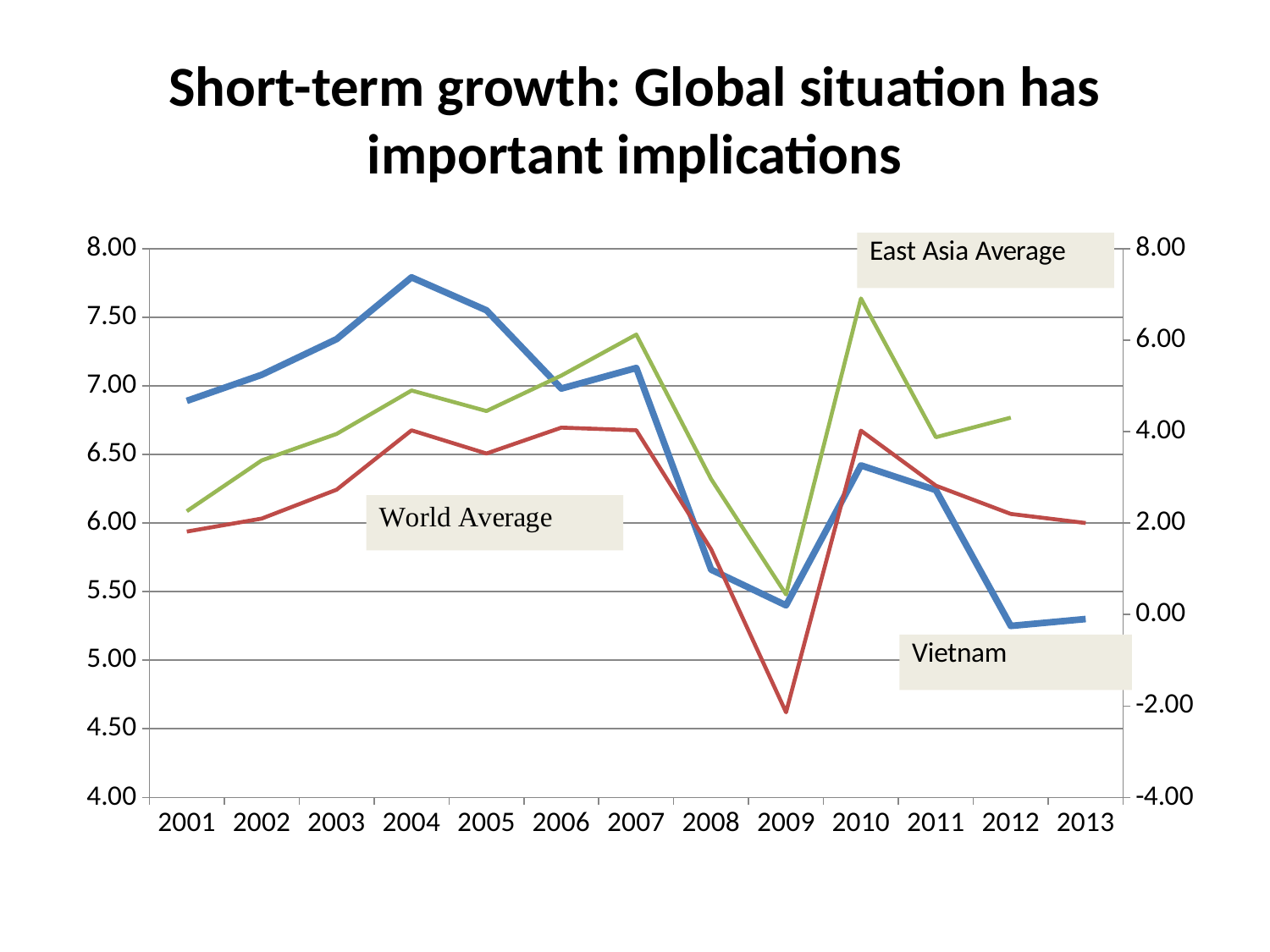
Is the East Asia Average value for 2010 greater or less than 6.00 on the right axis? greater How many years are shown along the x axis of the chart? 13 Is the World Average value for 2009 greater or less than 0.00 on the right axis? less What is the title of the slide containing the chart? Short-term growth: Global situation has important implications Does the Vietnam line rise or fall from 2010 to 2012? fall Is the Vietnam value for 2004 greater or less than 7.50 on the left axis? greater In which year does the East Asia Average line reach its highest value? 2010 What kind of chart is shown on the slide? line chart How many data series are plotted on the chart? 3 In which year does the Vietnam line reach its highest value? 2004 In which year does the World Average line reach its lowest value? 2009